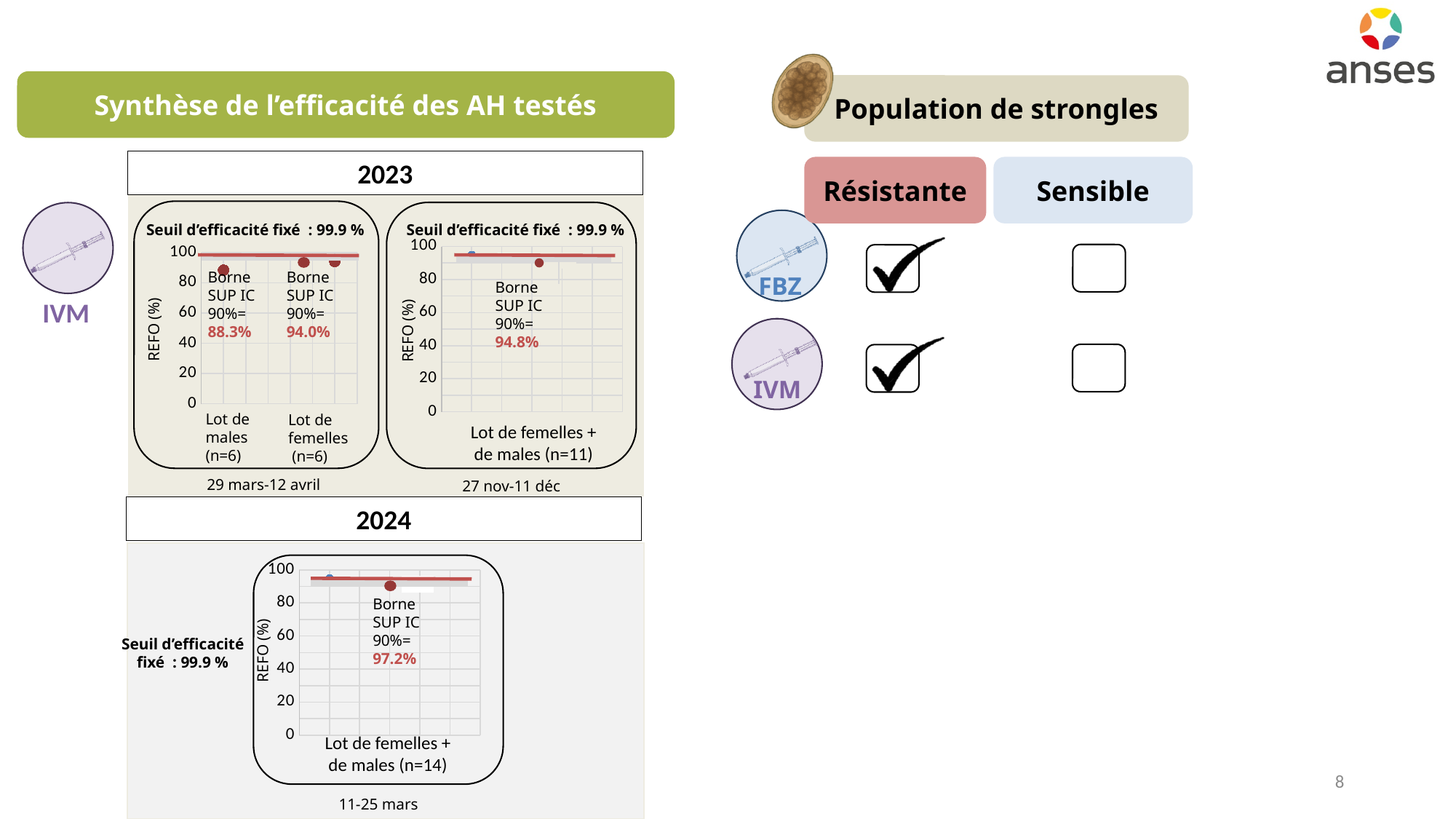
In the 2023 chart for 29 mars-12 avril, what is the Borne SUP IC 90% for Lot de males (n=6)? 88.3% In the 2023 chart for 29 mars-12 avril, which lot has the higher Borne SUP IC 90%, Lot de males or Lot de femelles? Lot de femelles In the 2023 chart for 29 mars-12 avril, what is the Borne SUP IC 90% for Lot de femelles (n=6)? 94.0% In the 2023 chart for 27 nov-11 déc, what is the Borne SUP IC 90% for Lot de femelles + de males (n=11)? 94.8% What is the label of the y axis on the 2024 chart? REFO (%) In the 2023 chart for 29 mars-12 avril, what is the difference between the Borne SUP IC 90% of Lot de femelles and Lot de males? 5.7% Across the three charts on the slide, which lot has the highest Borne SUP IC 90%? Lot de femelles + de males (n=14) in 2024 In the 2024 chart, is the plotted REFO value for Lot de femelles + de males (n=14) greater or less than 100? less Across the three charts on the slide, which lot has the lowest Borne SUP IC 90%? Lot de males (n=6) in 2023 In the 2023 chart for 29 mars-12 avril, is the plotted REFO value for Lot de males (n=6) greater or less than 60? greater In the 2024 chart, what is the Borne SUP IC 90% for Lot de femelles + de males (n=14)? 97.2% How many lots (categories) are plotted in the 2023 chart for 29 mars-12 avril? 2